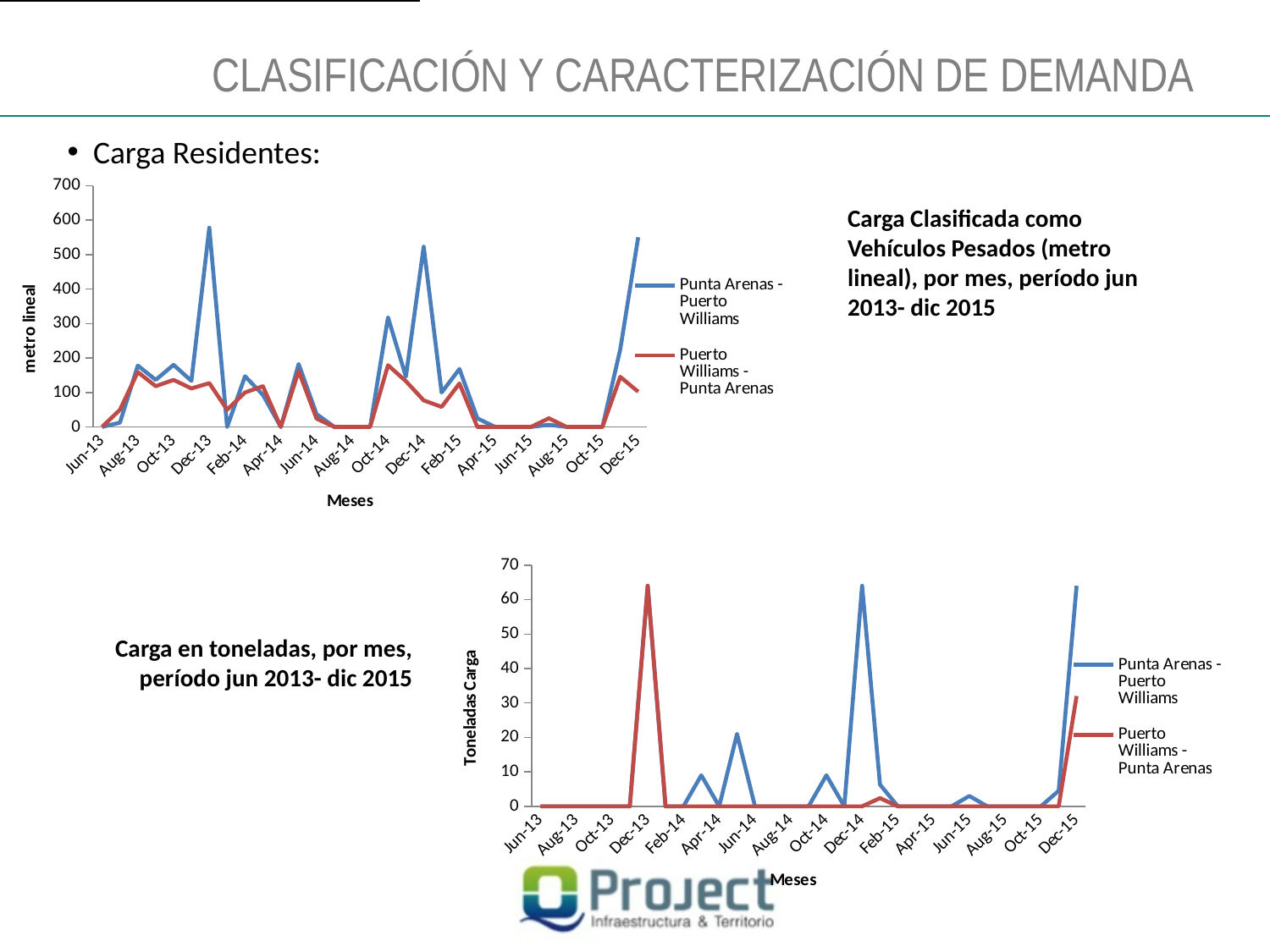
In the bottom chart (Toneladas Carga), is the value for Punta Arenas - Puerto Williams in Jun-14 greater or less than 30? less In the bottom chart (Toneladas Carga), which month has the highest value for Puerto Williams - Punta Arenas? Dec-13 In the bottom chart (Toneladas Carga), is the value for Puerto Williams - Punta Arenas in Dec-15 greater or less than 20? greater In the bottom chart (Toneladas Carga), which series has the larger value in Dec-14, Punta Arenas - Puerto Williams or Puerto Williams - Punta Arenas? Punta Arenas - Puerto Williams What is the x-axis title of the top chart (metro lineal)? Meses What is the y-axis title of the bottom chart? Toneladas Carga In the top chart (metro lineal), is the value for Punta Arenas - Puerto Williams in Dec-13 greater or less than 500? greater In the top chart (metro lineal), which series has the larger value in Dec-13, Punta Arenas - Puerto Williams or Puerto Williams - Punta Arenas? Punta Arenas - Puerto Williams How many month labels are shown on the x axis of the top chart (metro lineal)? 16 What type of chart is the top chart (metro lineal)? line chart How many series does the legend of the bottom chart (Toneladas Carga) list? 2